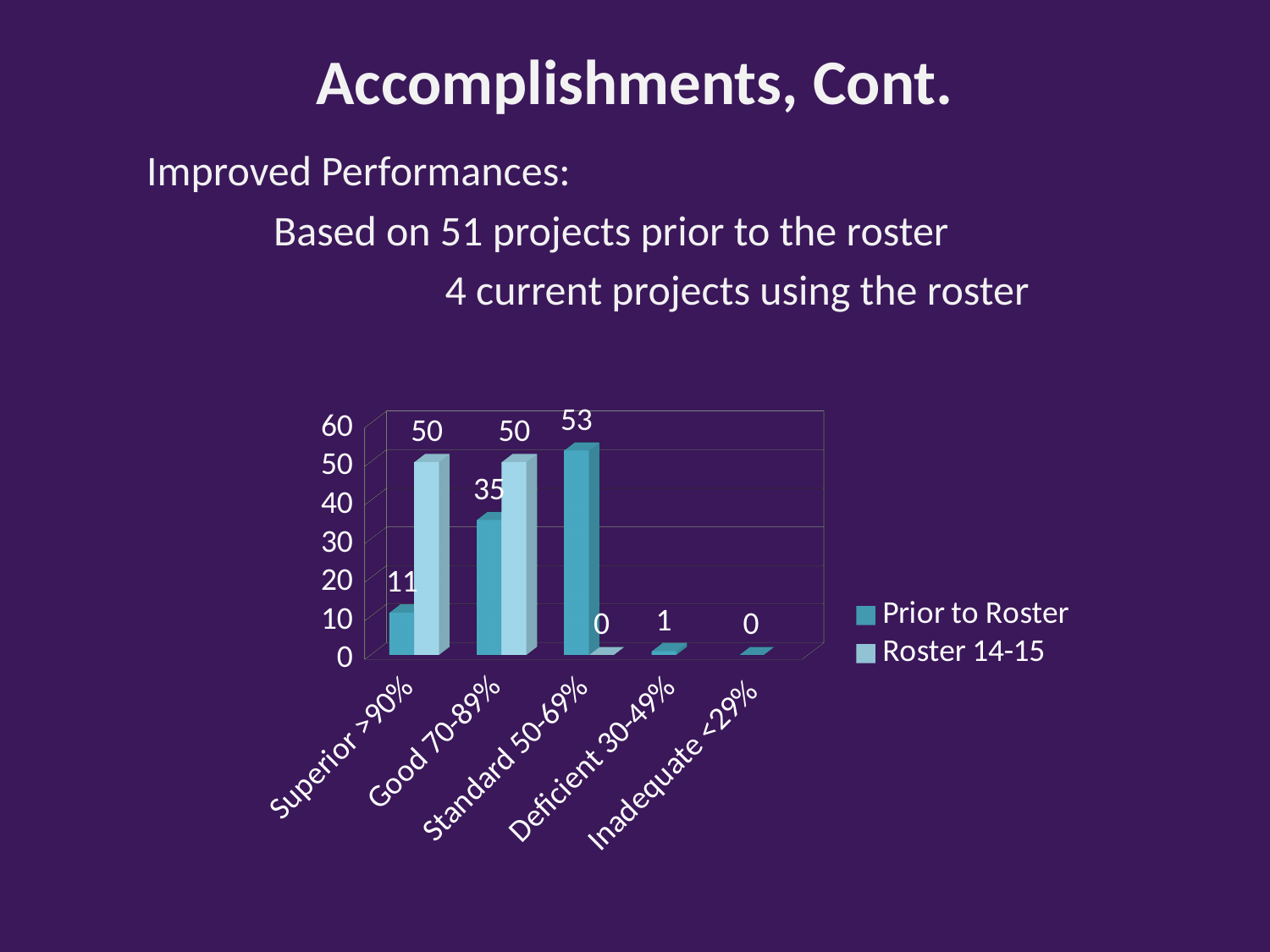
What is the difference between the Roster 14-15 and Prior to Roster values for Superior >90%? 39 For Good 70-89%, which series has the larger value, Prior to Roster or Roster 14-15? Roster 14-15 What is the Prior to Roster value for Deficient 30-49%? 1 What kind of chart is shown on the slide? bar chart What are the two entries in the chart legend? Prior to Roster and Roster 14-15 What is the Roster 14-15 value for Good 70-89%? 50 Which category has the highest Prior to Roster value? Standard 50-69% How many series does the chart legend list? 2 What is the Prior to Roster value for Superior >90%? 11 How many categories are shown on the x axis of the chart? 5 What is the Prior to Roster value for Standard 50-69%? 53 What is the Roster 14-15 value for Standard 50-69%? 0